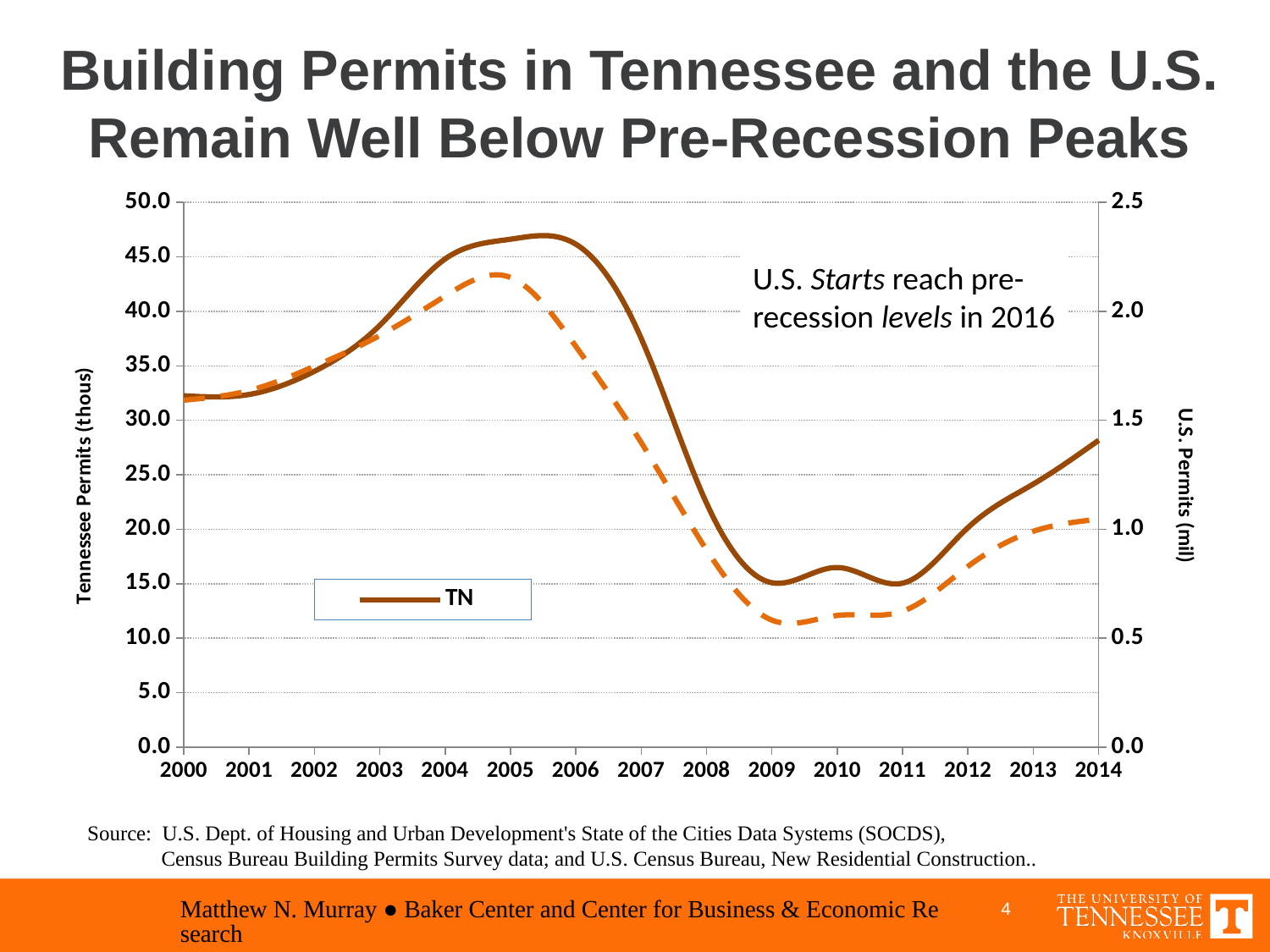
How many series does the chart's legend list? 1 Is the TN value in 2005 greater or less than 40.0? greater Does the TN line rise or fall between 2006 and 2009? fall Is the TN value in 2012 greater or less than 25.0? less What is the label of the left vertical axis? Tennessee Permits (thous) Is the TN value in 2014 greater or less than 25.0? greater How many years are labeled on the x axis of the chart? 15 Does the TN line rise or fall between 2011 and 2014? rise What is the label of the right vertical axis? U.S. Permits (mil) What kind of chart is shown on the slide? line chart